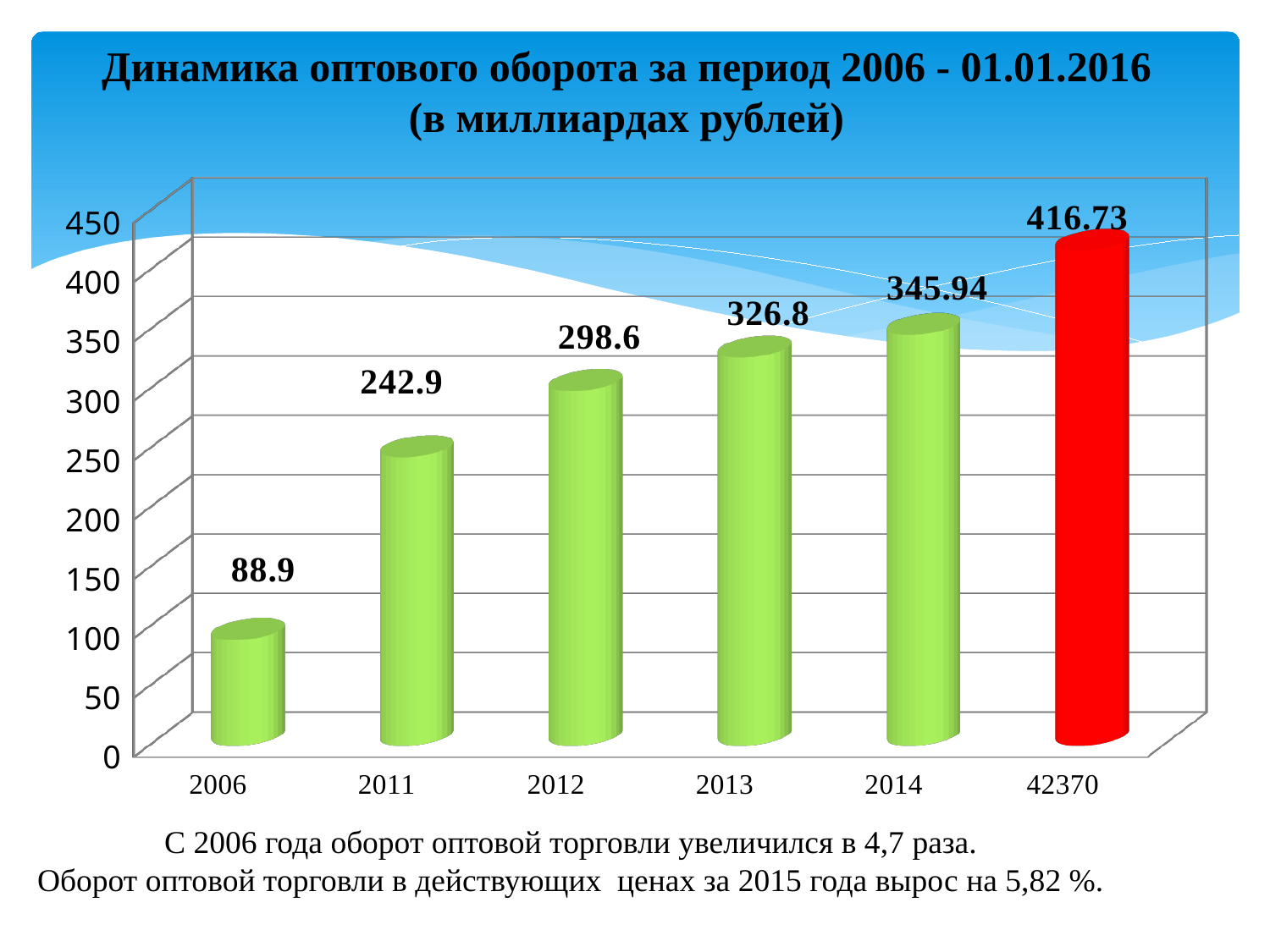
What is the difference between the values for 2011 and 2006? 154 Which is larger, the value for 2012 or the value for 2014? 2014 How many categories are shown on the x axis? 6 Which category has the lowest value? 2006 Do the values rise or fall from left to right along the x axis? rise What is the value for 2014? 345.94 What kind of chart is shown on the slide? bar chart What is the value for the category labelled 42370? 416.73 What is the value for 2006? 88.9 What is the value for 2013? 326.8 What is the difference between the values for 2013 and 2012? 28.2 Which category has the highest value? 42370